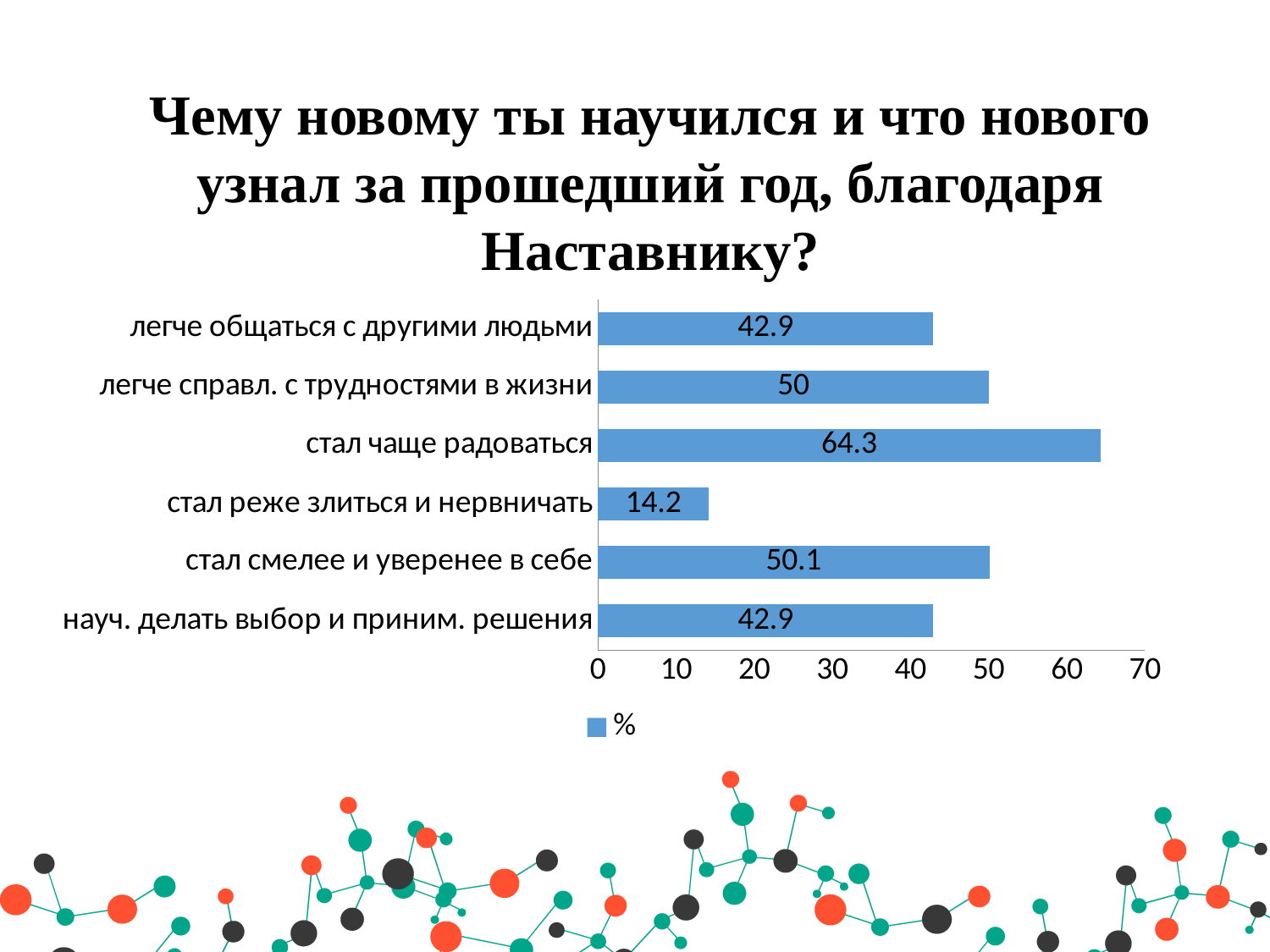
Is the value for "стал реже злиться и нервничать" greater or less than 20? less What is the value for "стал реже злиться и нервничать"? 14.2 What is the value for "стал чаще радоваться"? 64.3 What is the value for "стал смелее и уверенее в себе"? 50.1 What is the value for "легче справл. с трудностями в жизни"? 50 Which category has the highest value? стал чаще радоваться What is the difference between the values for "стал чаще радоваться" and "стал реже злиться и нервничать"? 50.1 Which is larger: the value for "легче общаться с другими людьми" or the value for "стал чаще радоваться"? стал чаще радоваться What entry does the legend show? % Which category has the lowest value? стал реже злиться и нервничать How many categories are shown in the chart? 6 What kind of chart is shown on the slide? bar chart